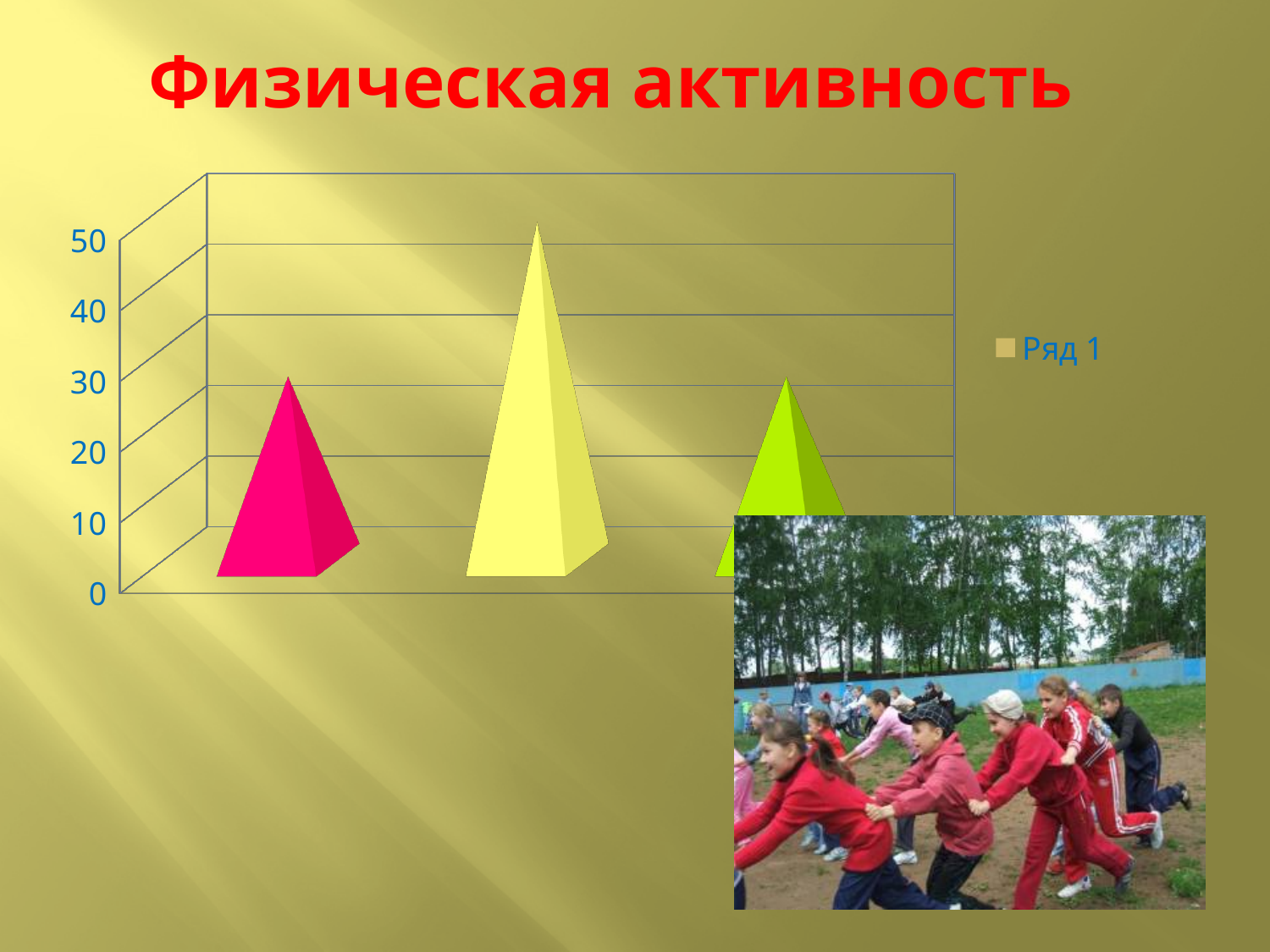
Is the value of the pink (left) bar greater or less than 40? less Is the value of the green (right) bar greater or less than 40? less What kind of chart is shown on the slide? bar chart Which bar is the tallest in the chart: the pink (left), the yellow (middle) or the green (right)? the yellow (middle) How many series does the chart legend list? 1 Is the value of the pink (left) bar greater or less than 20? greater How many bars are plotted in the chart? 3 What is the highest value shown on the vertical axis of the chart? 50 Which is larger, the value of the yellow (middle) bar or the value of the green (right) bar? the yellow (middle) bar What is the name of the series shown in the chart legend? Ряд 1 What is the title of the chart on the slide? Физическая активность